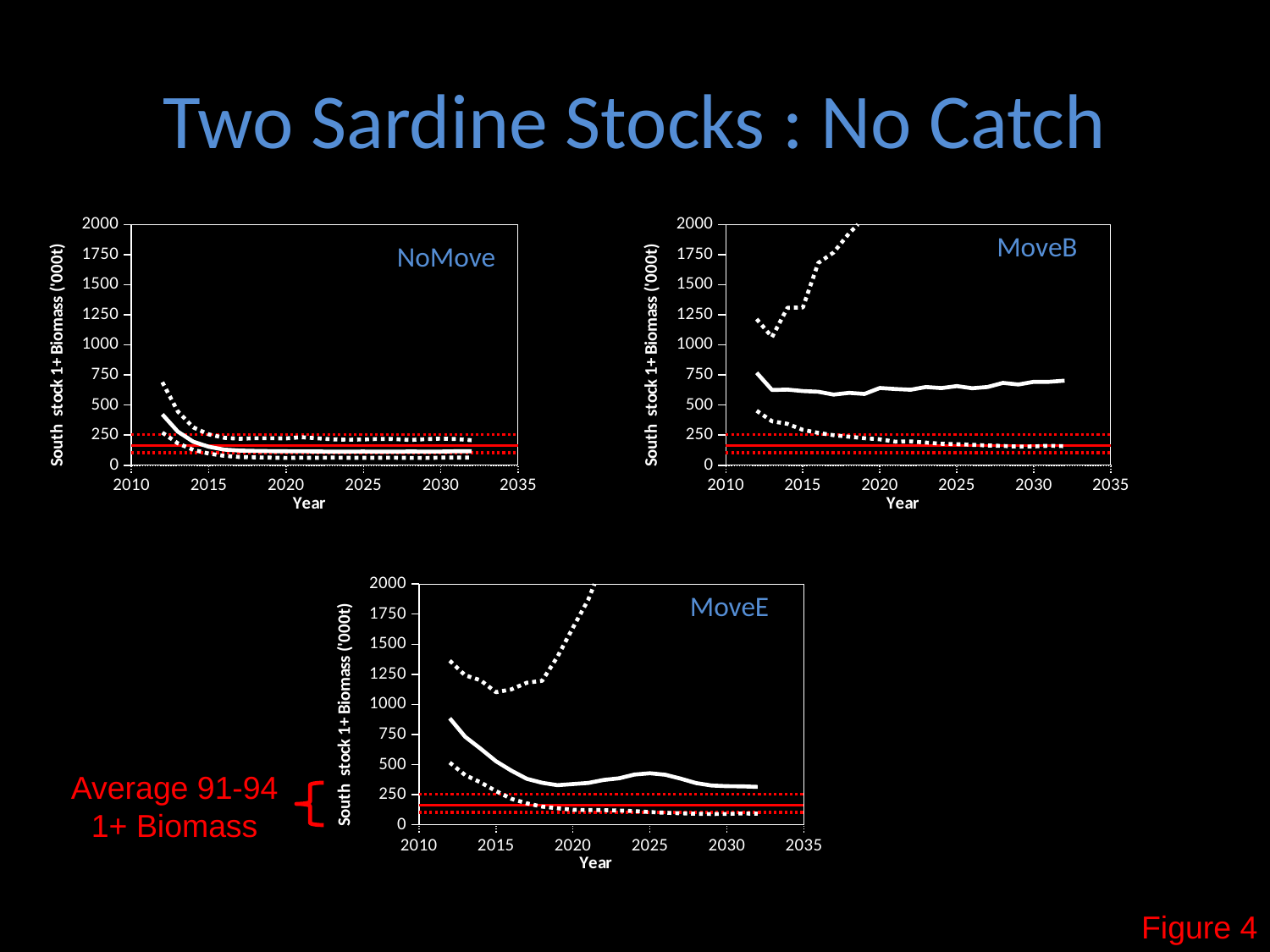
In the NoMove chart, is the value of the solid white line at 2030 greater or less than 500? less In the MoveE chart, does the upper dotted white line rise or fall between 2015 and 2020? rise Which chart has the highest solid white line value at 2032: NoMove, MoveB or MoveE? MoveB What are the labels of the three charts on the slide? NoMove, MoveB, MoveE In the MoveE chart, is the value of the solid white line at 2030 greater or less than 500? less What is the y-axis label on the NoMove chart? South stock 1+ Biomass ('000t) In the MoveE chart, is the value of the solid white line at 2012 greater or less than 500? greater What kind of chart is the NoMove chart? line chart How many charts are shown on the slide? 3 In the NoMove chart, does the solid white line rise or fall between 2012 and 2016? fall